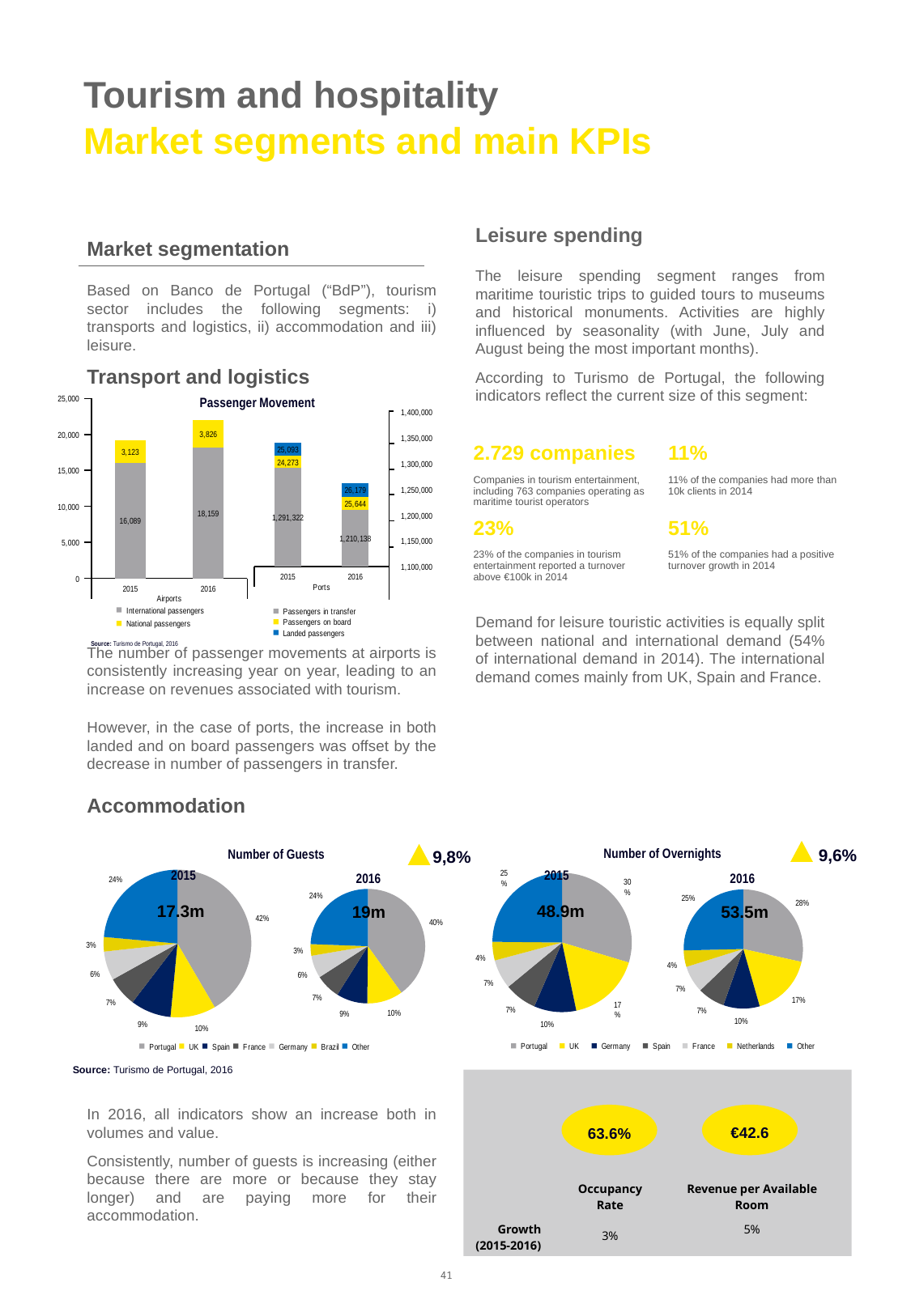
In the Passenger Movement chart, were there more landed passengers at ports in 2015 or in 2016? 2016 In the Passenger Movement chart, by how much did international passengers at airports increase from 2015 to 2016? 2,070 In the Passenger Movement chart, how many international passengers were recorded at airports in 2016? 18,159 In the Number of Overnights chart, which country has the largest slice in 2016? Portugal What kind of chart is the Passenger Movement chart? bar chart In the Number of Guests chart, what is the total number of guests shown for 2016? 19m How many entries does the legend of the Number of Guests chart list? 7 In the Passenger Movement chart, what is the total of the stacked bar for airports in 2015? 19,212 In the Passenger Movement chart, how many passengers in transfer were recorded at ports in 2015? 1,291,322 In the Number of Overnights chart, what share of overnights in 2015 is attributed to the UK? 17% In the Passenger Movement chart, how many national passengers were recorded at airports in 2015? 3,123 In the Number of Guests chart, what share of guests in 2015 came from Portugal? 42%